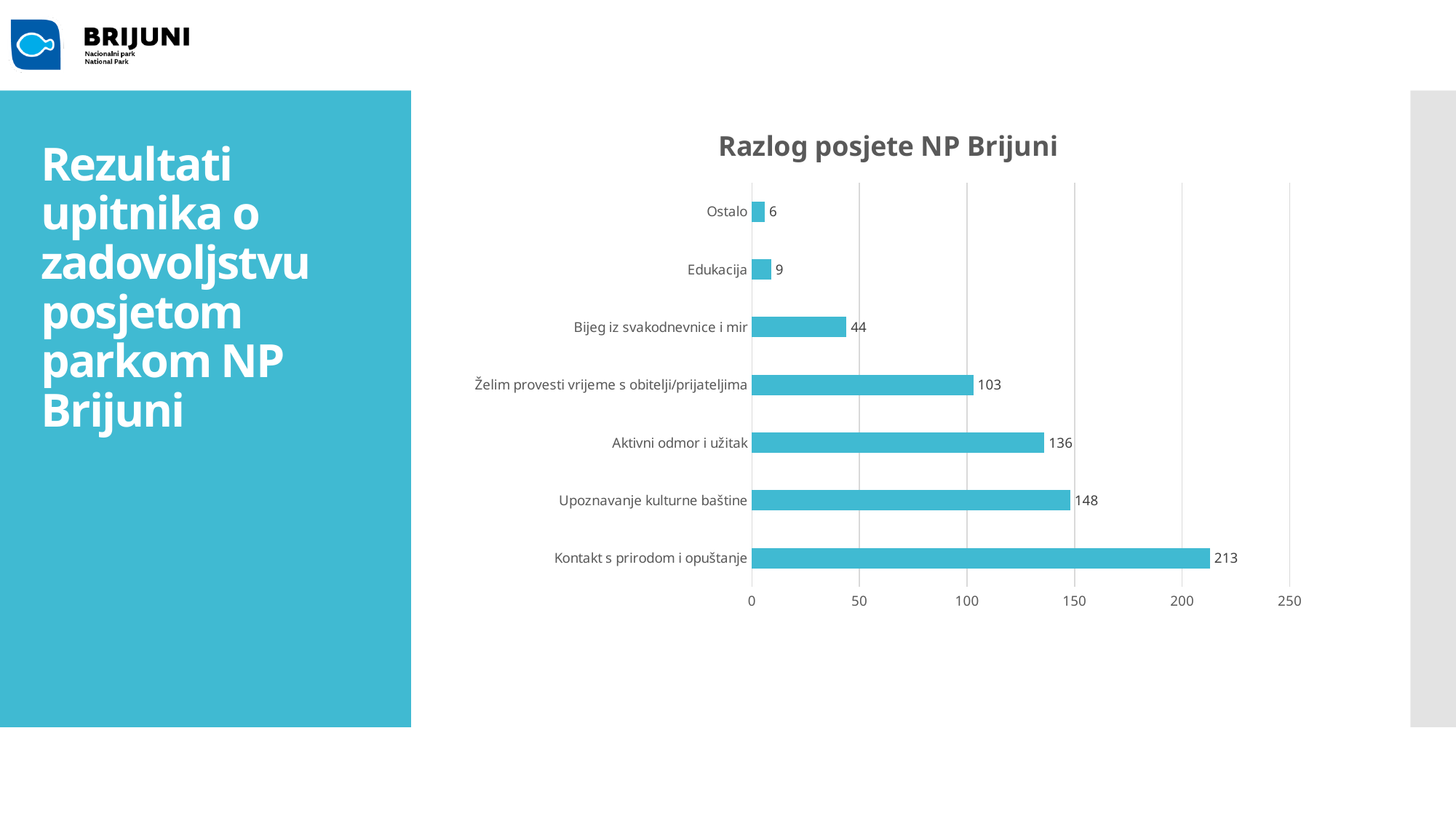
What type of chart is shown on the slide? Bar chart Which is larger, Aktivni odmor i užitak or Želim provesti vrijeme s obitelji/prijateljima? Aktivni odmor i užitak What is the value for Kontakt s prirodom i opuštanje? 213 What is the difference between Kontakt s prirodom i opuštanje and Upoznavanje kulturne baštine? 65 What is the value for Edukacija? 9 Which category has the lowest value? Ostalo How many categories are shown in the chart? 7 What is the difference between Aktivni odmor i užitak and Želim provesti vrijeme s obitelji/prijateljima? 33 Which category has the highest value? Kontakt s prirodom i opuštanje What is the value for Upoznavanje kulturne baštine? 148 Is the value for Upoznavanje kulturne baštine greater or less than 100? greater What is the value for Bijeg iz svakodnevnice i mir? 44